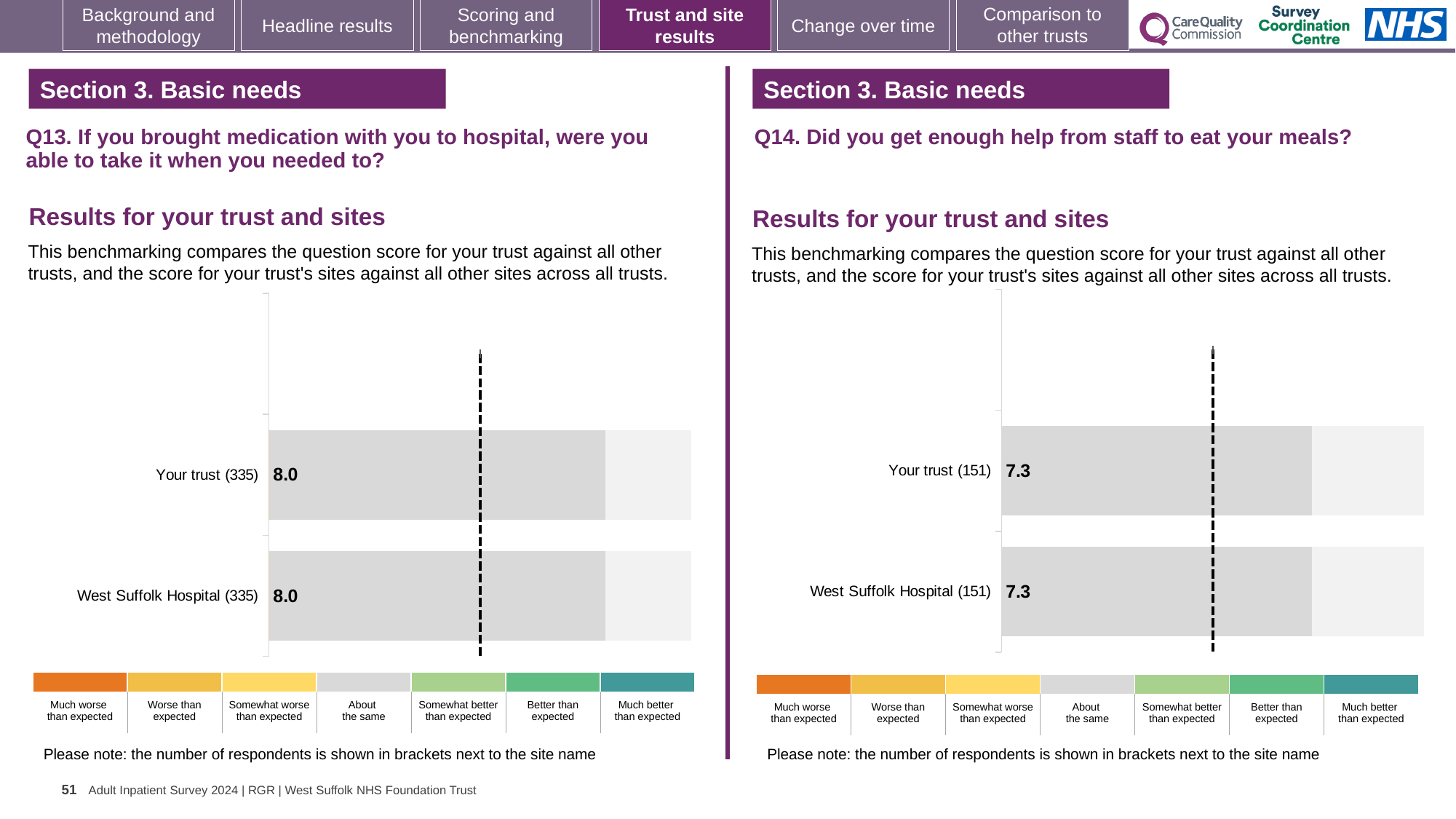
On the Q14 chart (right), what is the score for Your trust? 7.3 What kind of chart is the Q13 chart (left)? Bar chart How many bars are plotted on the Q14 chart (right)? 2 On the Q14 chart (right), what is the difference between the score for Your trust and the score for West Suffolk Hospital? 0.0 On the Q13 chart (left), how many respondents are shown in brackets next to Your trust? 335 On the Q13 chart (left), what is the score for West Suffolk Hospital? 8.0 On the Q14 chart (right), what is the score for West Suffolk Hospital? 7.3 Is the score for Your trust on the Q13 chart (left) larger or smaller than the score for Your trust on the Q14 chart (right)? Larger How many bars are plotted on the Q13 chart (left)? 2 On the Q13 chart (left), what is the difference between the score for Your trust and the score for West Suffolk Hospital? 0.0 On the Q13 chart (left), what is the score for Your trust? 8.0 On the Q14 chart (right), how many respondents are shown in brackets next to West Suffolk Hospital? 151